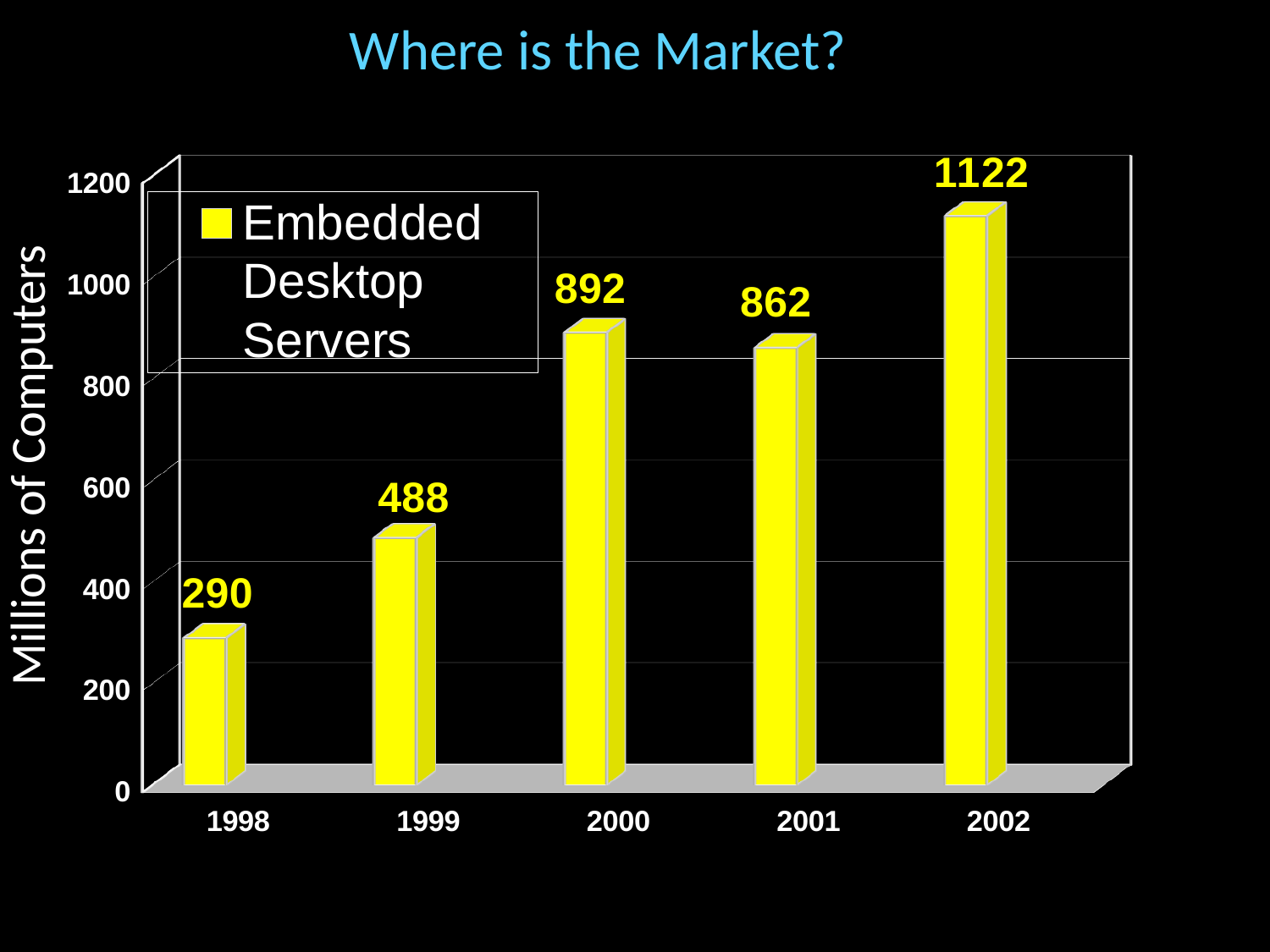
Which year has the highest value? 2002 What is the difference between the values for 2002 and 2001? 260 What is the value for 2002? 1122 What kind of chart is shown on the slide? bar chart What is the label of the vertical axis? Millions of Computers How many years are shown on the x axis? 5 What is the value for 1998? 290 What is the difference between the values for 1999 and 1998? 198 Which is larger, the value for 2000 or the value for 2001? 2000 What is the value for 2000? 892 Which year has the lowest value? 1998 What is the title of the slide? Where is the Market?